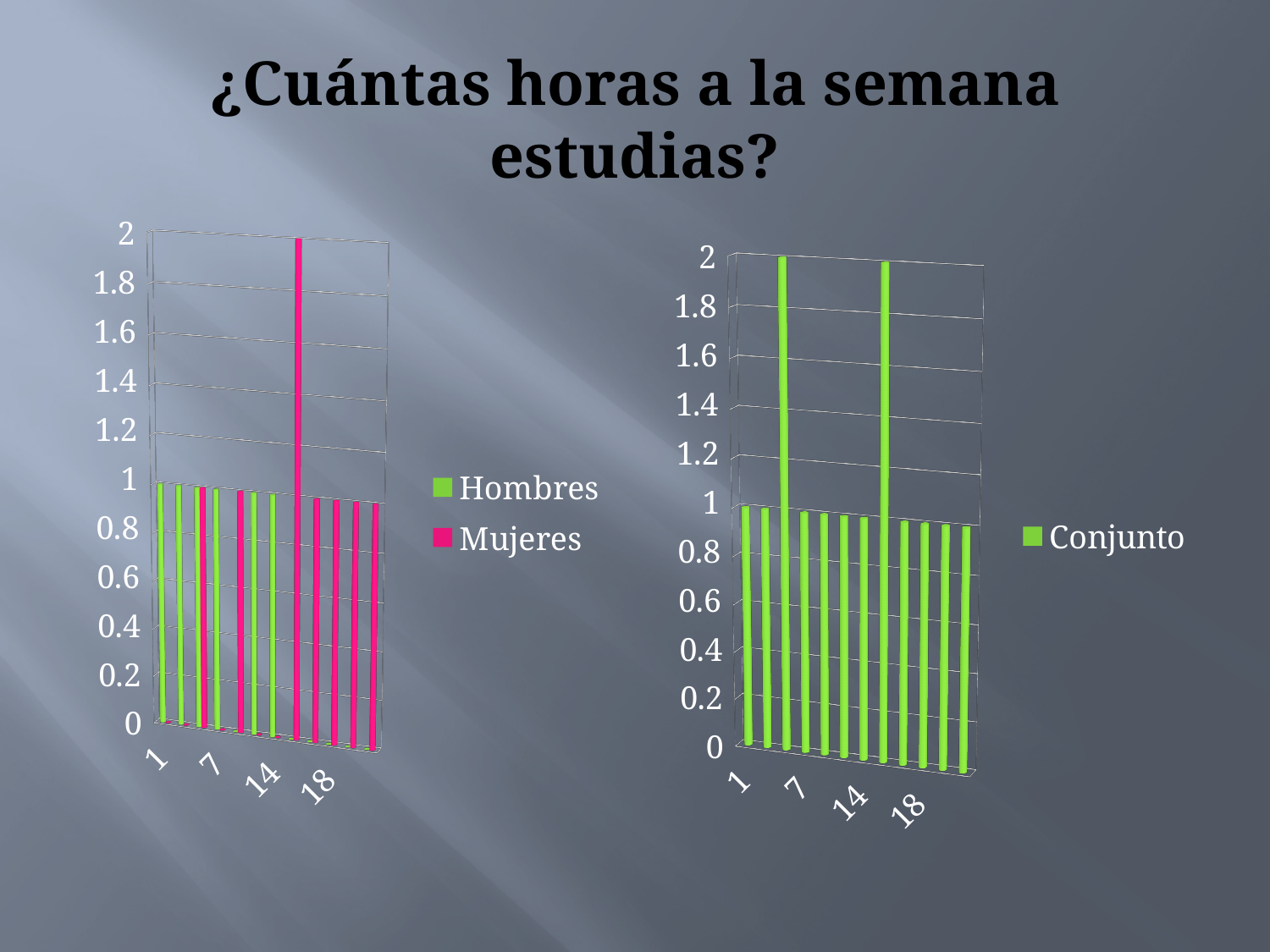
In the left chart, is the value for category 1 greater or less than 1.5? less What is the title shown above the charts on the slide? ¿Cuántas horas a la semana estudias? How many series does the legend of the right chart list? 1 What kind of chart is the left chart on the slide? bar chart In the left chart, what is the highest value reached by any bar? 2 How many bars are plotted in the right chart? 12 In the right chart, what is the highest value reached by any bar? 2 How many series does the legend of the left chart list? 2 What are the legend entries of the left chart? Hombres, Mujeres What kind of chart is the right chart on the slide? bar chart In the right chart, is the value for category 1 greater or less than 1.5? less In the right chart, what is the maximum value shown on the vertical axis? 2